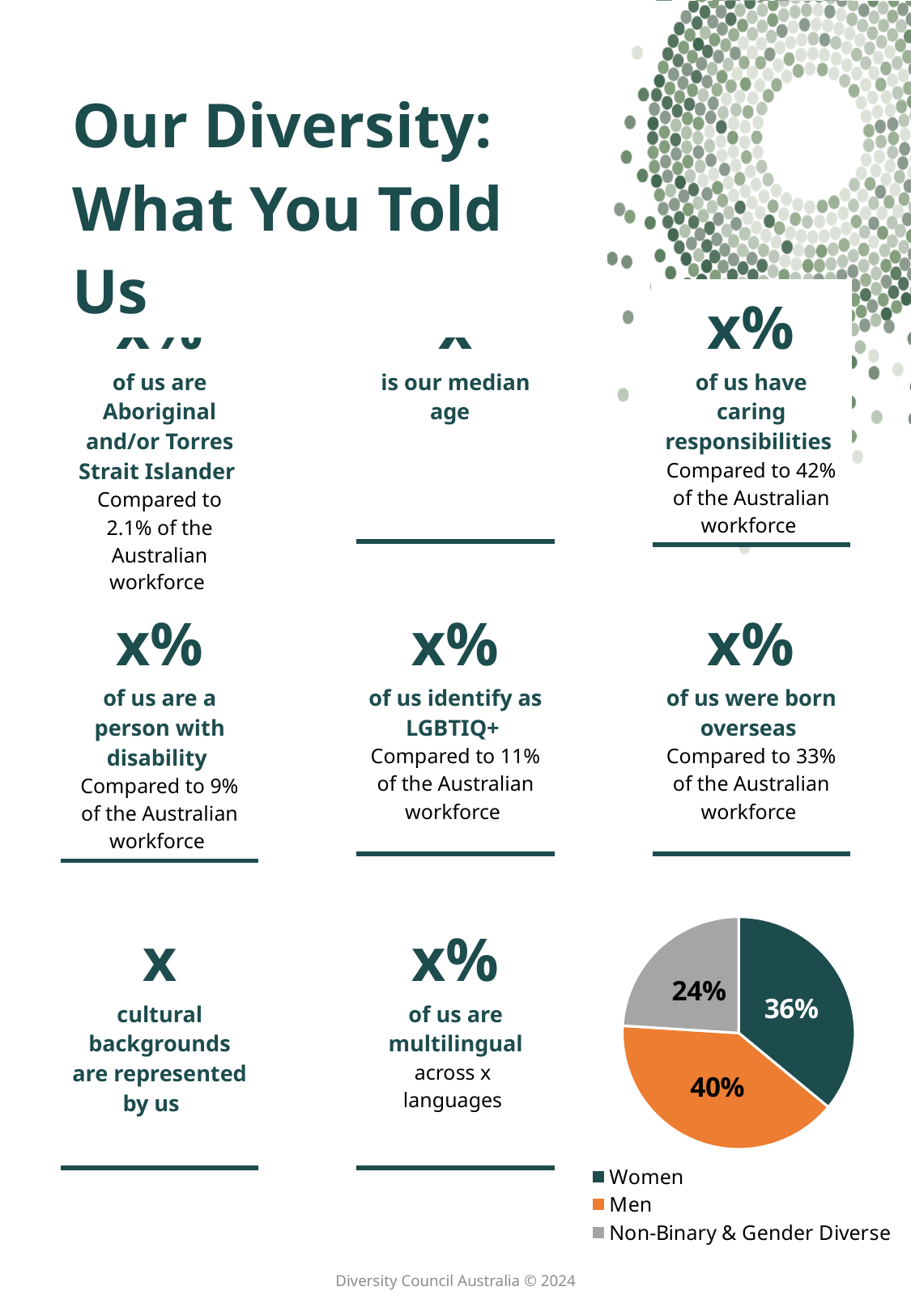
What is the difference in percentage points between the Men and Women slices? 4 What share of the pie chart is Non-Binary & Gender Diverse? 24% Which category has the smallest slice in the pie chart? Non-Binary & Gender Diverse What is the difference in percentage points between the Women and Non-Binary & Gender Diverse slices? 12 What share of the pie chart is Men? 40% Which category has the largest slice in the pie chart? Men What colour is the Men slice in the pie chart? orange What share of the pie chart is Women? 36% What kind of chart is shown on the slide? pie chart How many slices does the pie chart have? 3 Which slice is larger, Women or Non-Binary & Gender Diverse? Women How many entries does the pie chart legend list? 3